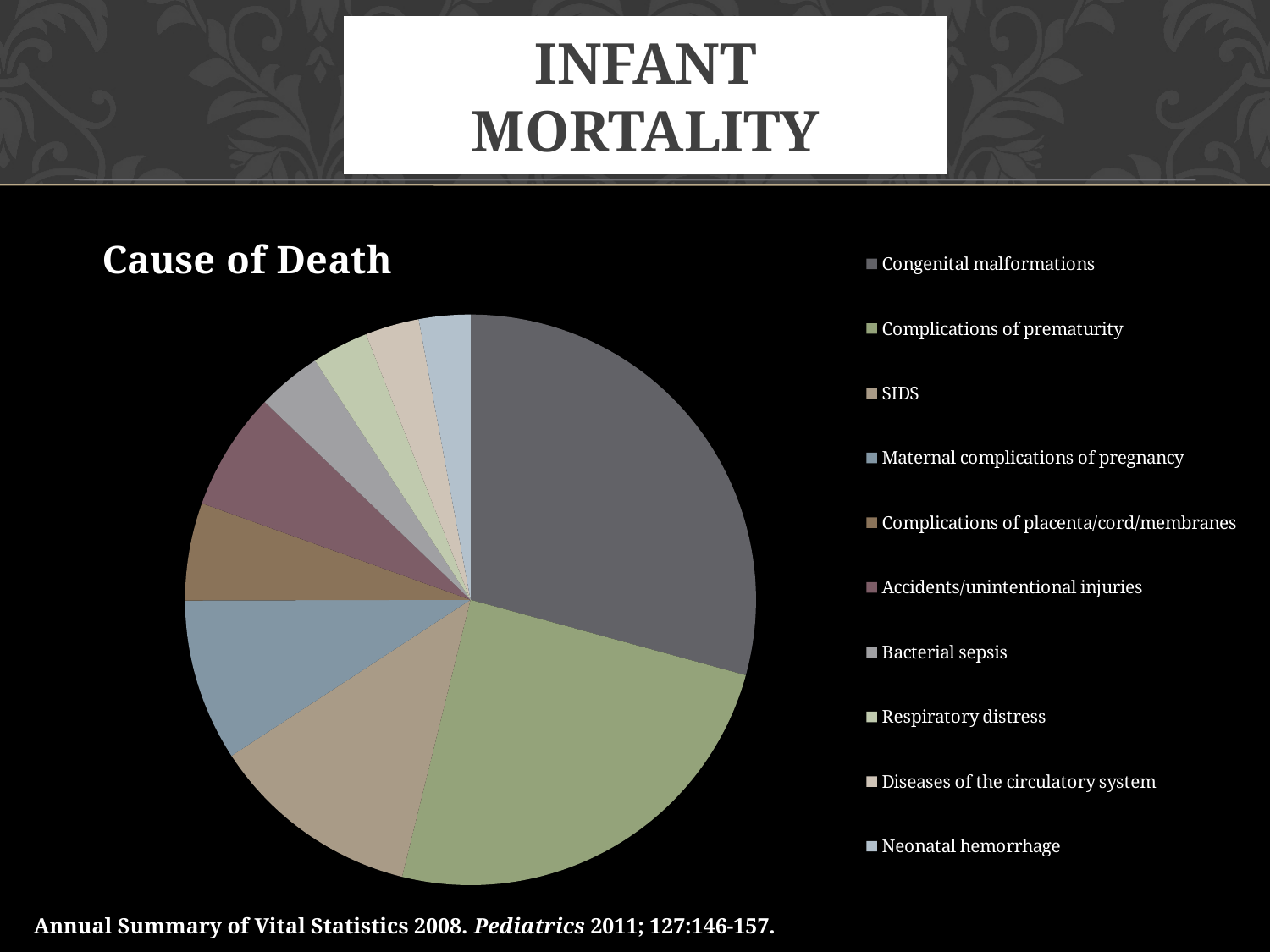
Which slice is larger: Complications of placenta/cord/membranes or Neonatal hemorrhage? Complications of placenta/cord/membranes Which cause of death has the largest slice of the pie? Congenital malformations Which cause of death is listed first in the legend? Congenital malformations Which slice is larger: SIDS or Accidents/unintentional injuries? SIDS Which slice is larger: Complications of prematurity or SIDS? Complications of prematurity How many causes of death are shown in the pie chart? 10 What kind of chart is shown on the slide? pie chart What is the title of the chart? Cause of Death